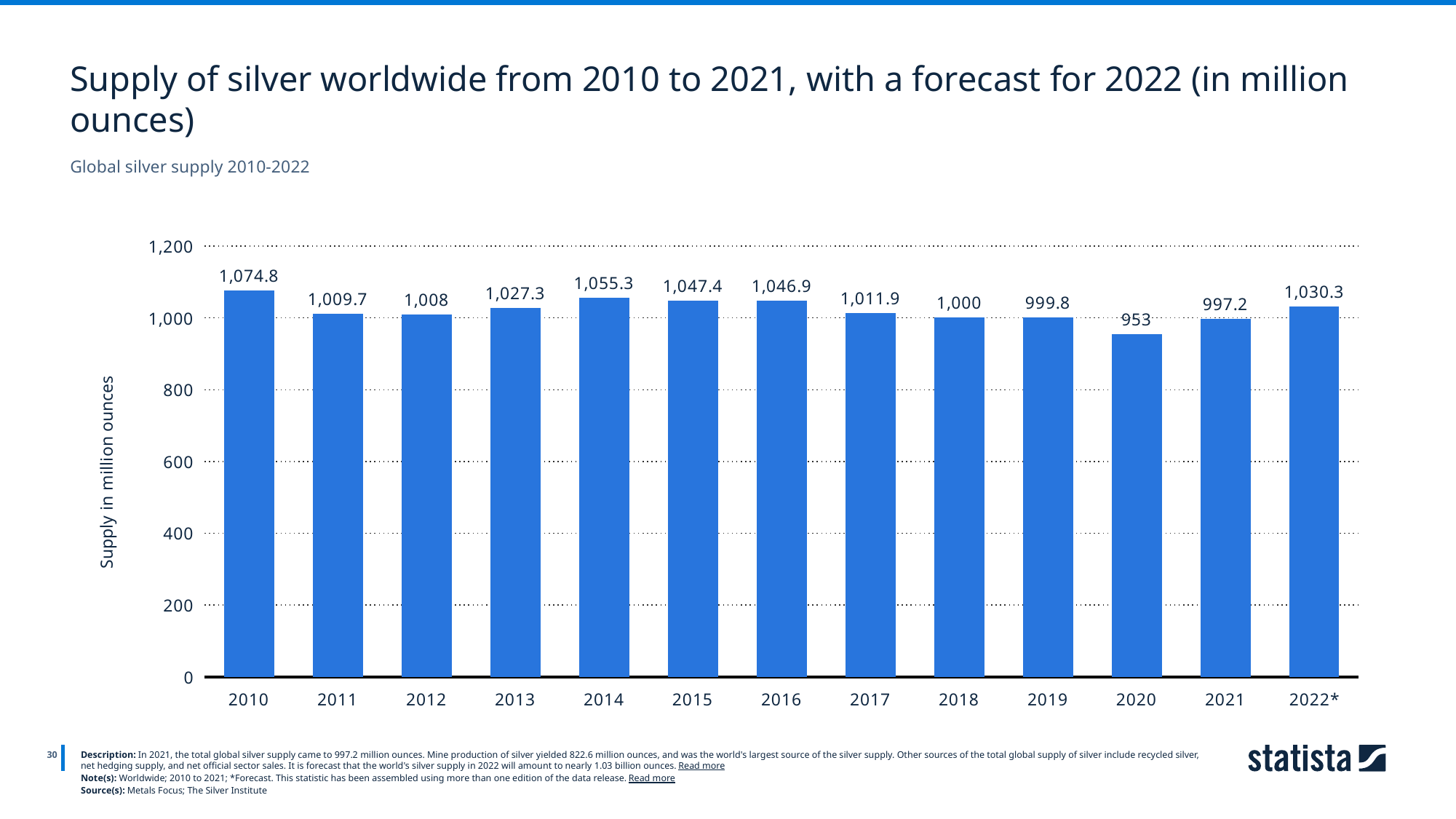
What kind of chart is shown on the slide? bar chart What was the global silver supply in 2010? 1,074.8 What was the silver supply in 2020? 953 Which year has the highest silver supply? 2010 Which year had a larger silver supply, 2014 or 2015? 2014 What is the label of the y axis? Supply in million ounces Is the value for 2021 greater or less than 1,000? less Did the silver supply rise or fall from 2020 to 2021? rise What is the difference between the silver supply in 2010 and 2020? 121.8 Which year has the lowest silver supply? 2020 What is the forecast silver supply for 2022*? 1,030.3 How many years are shown on the x axis? 13